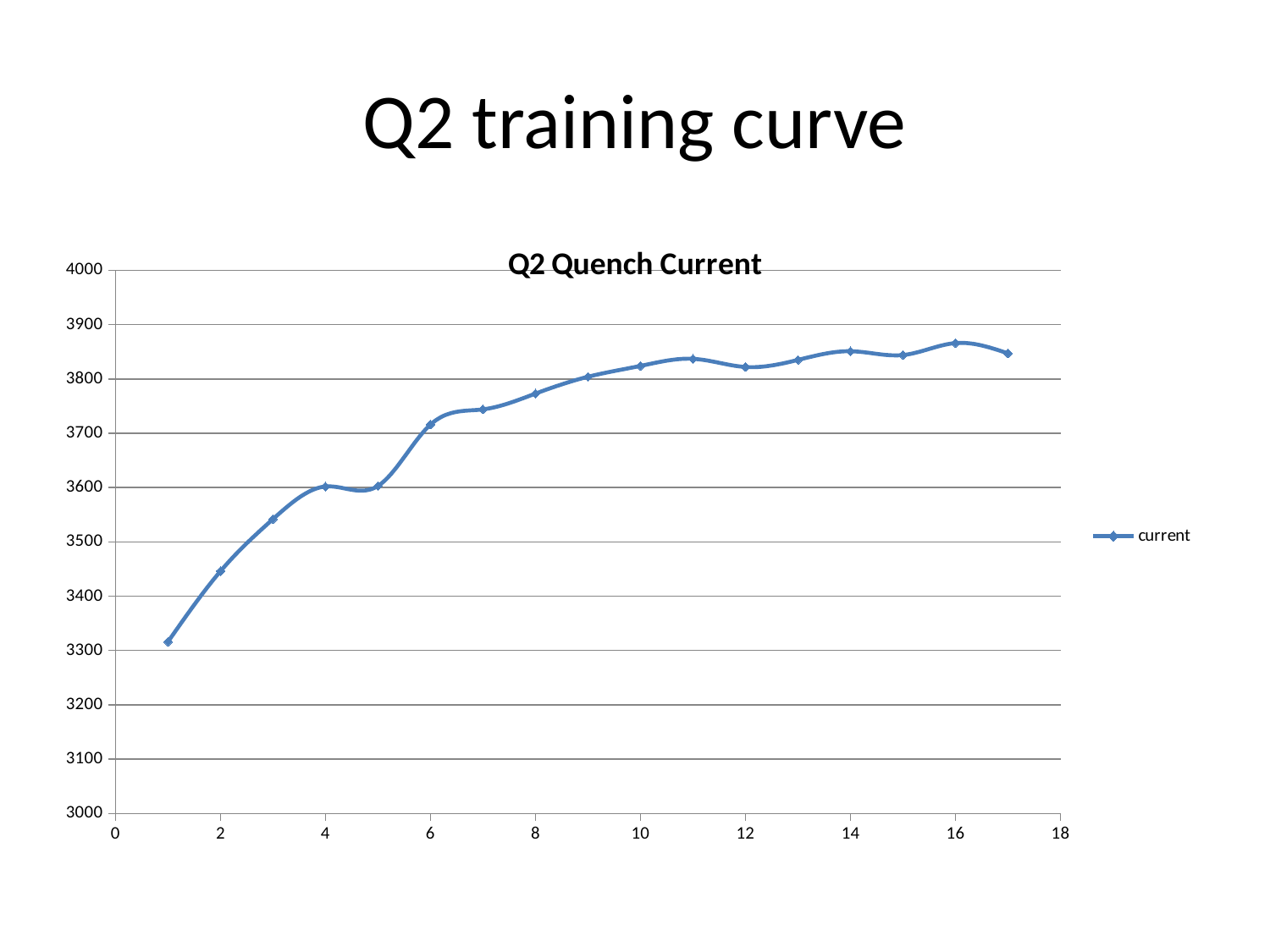
How many data points are plotted on the chart? 17 Do the values generally rise or fall as x increases? rise Which is larger, the value at x = 3 or the value at x = 6? x = 6 Is the value at x = 6 greater or less than 3700? greater What is the title of the chart? Q2 Quench Current At which x value is the current highest? 16 Is the value at x = 1 greater or less than 3400? less Is the value at x = 8 greater or less than 3800? less How many series does the legend list? 1 What kind of chart is shown on the slide? line chart What is the name of the series in the legend? current At which x value is the current lowest? 1